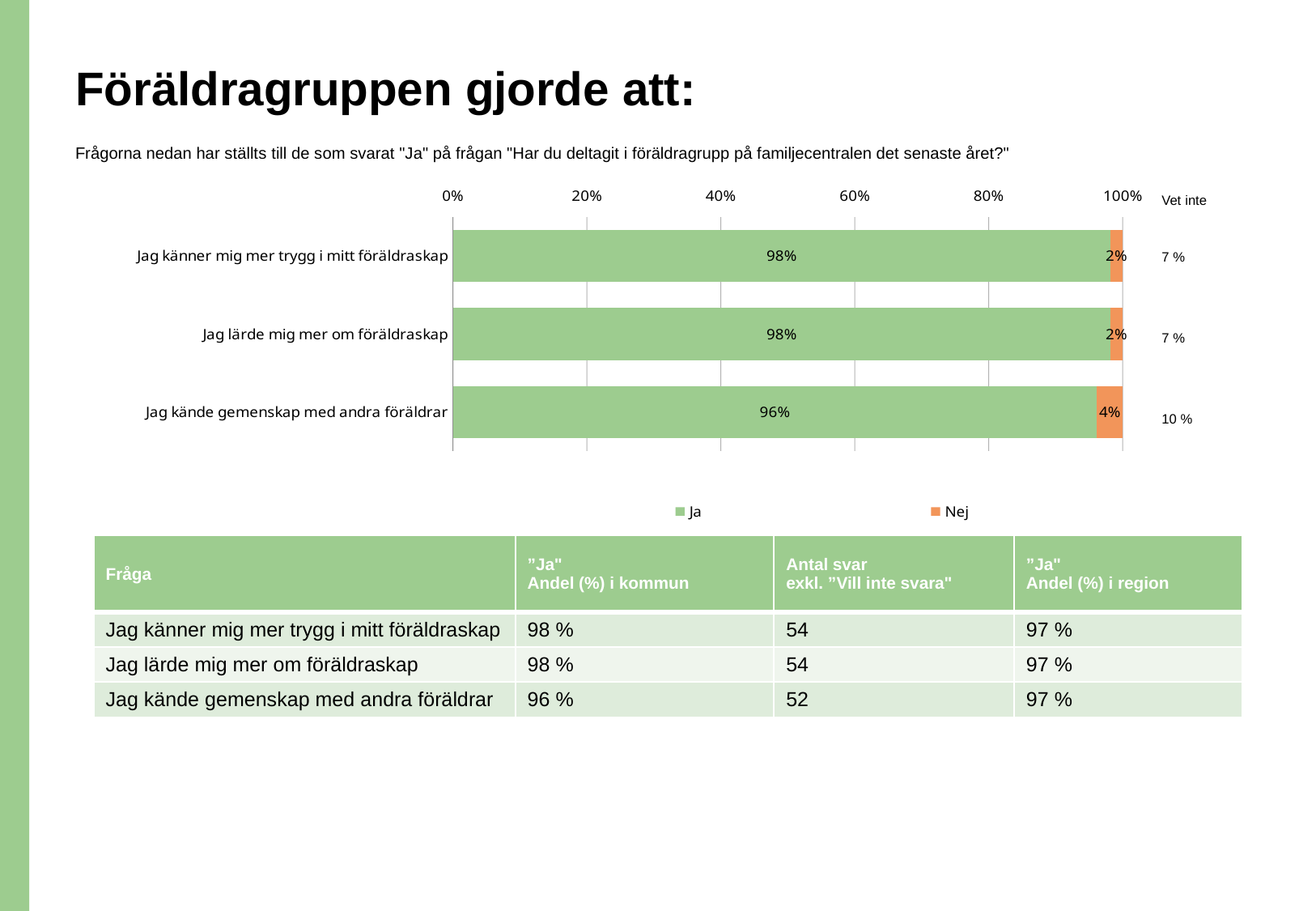
What is the "Nej" value for "Jag kände gemenskap med andra föräldrar"? 4% What is the "Ja" value for "Jag känner mig mer trygg i mitt föräldraskap"? 98% What colour represents the "Nej" series in the chart? Orange Which category has the highest "Nej" value? Jag kände gemenskap med andra föräldrar What is the "Ja" value for "Jag kände gemenskap med andra föräldrar"? 96% How many categories are shown in the chart? 3 How many series does the legend list? 2 What is the difference between the "Ja" values for "Jag lärde mig mer om föräldraskap" and "Jag kände gemenskap med andra föräldrar"? 2% Which category has the lowest "Ja" value? Jag kände gemenskap med andra föräldrar Which is larger: the "Nej" value for "Jag kände gemenskap med andra föräldrar" or for "Jag känner mig mer trygg i mitt föräldraskap"? Jag kände gemenskap med andra föräldrar What is the "Nej" value for "Jag lärde mig mer om föräldraskap"? 2% What kind of chart is shown on the slide? Stacked bar chart